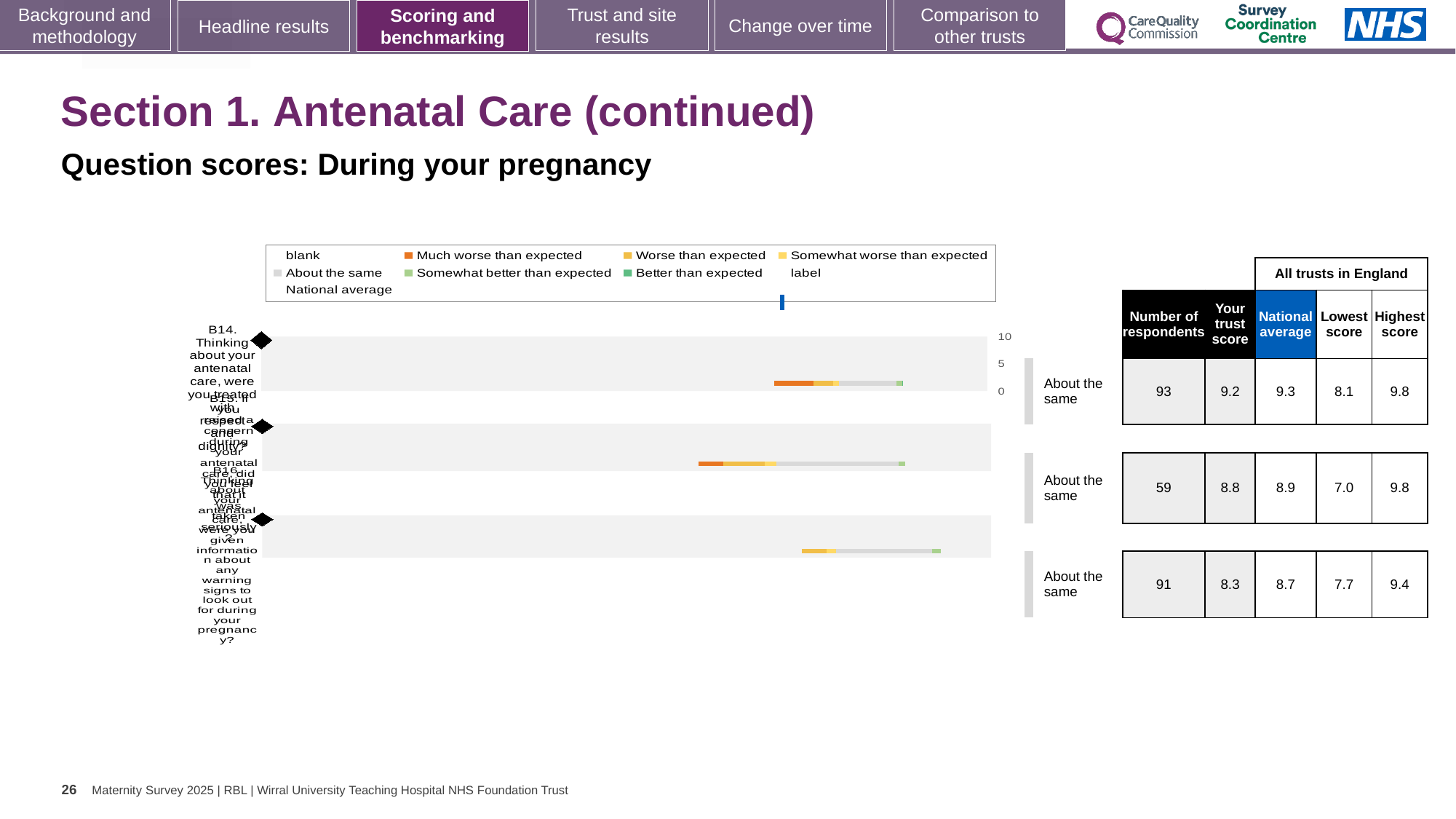
What is the trust score for the first question (B14)? 9.2 Which of the three questions has the fewest respondents? B15 (second question) What kind of chart is used to show the question scores on this slide? bar chart Which of the three questions has the lowest trust score? B16 (third question) Is the trust score for the first question (B14) larger or smaller than the trust score for the second question (B15)? larger What is the highest score among all trusts in England for the third question (B16)? 9.4 What is the national average for the first question (B14)? 9.3 What is the difference between the national average and the trust score for the third question (B16)? 0.4 What is the number of respondents for the first question (B14) in the table? 93 What is the lowest score among all trusts in England for the second question (B15)? 7.0 How many questions (bars) are plotted in the chart? 3 What benchmark category is shown for all three questions? About the same